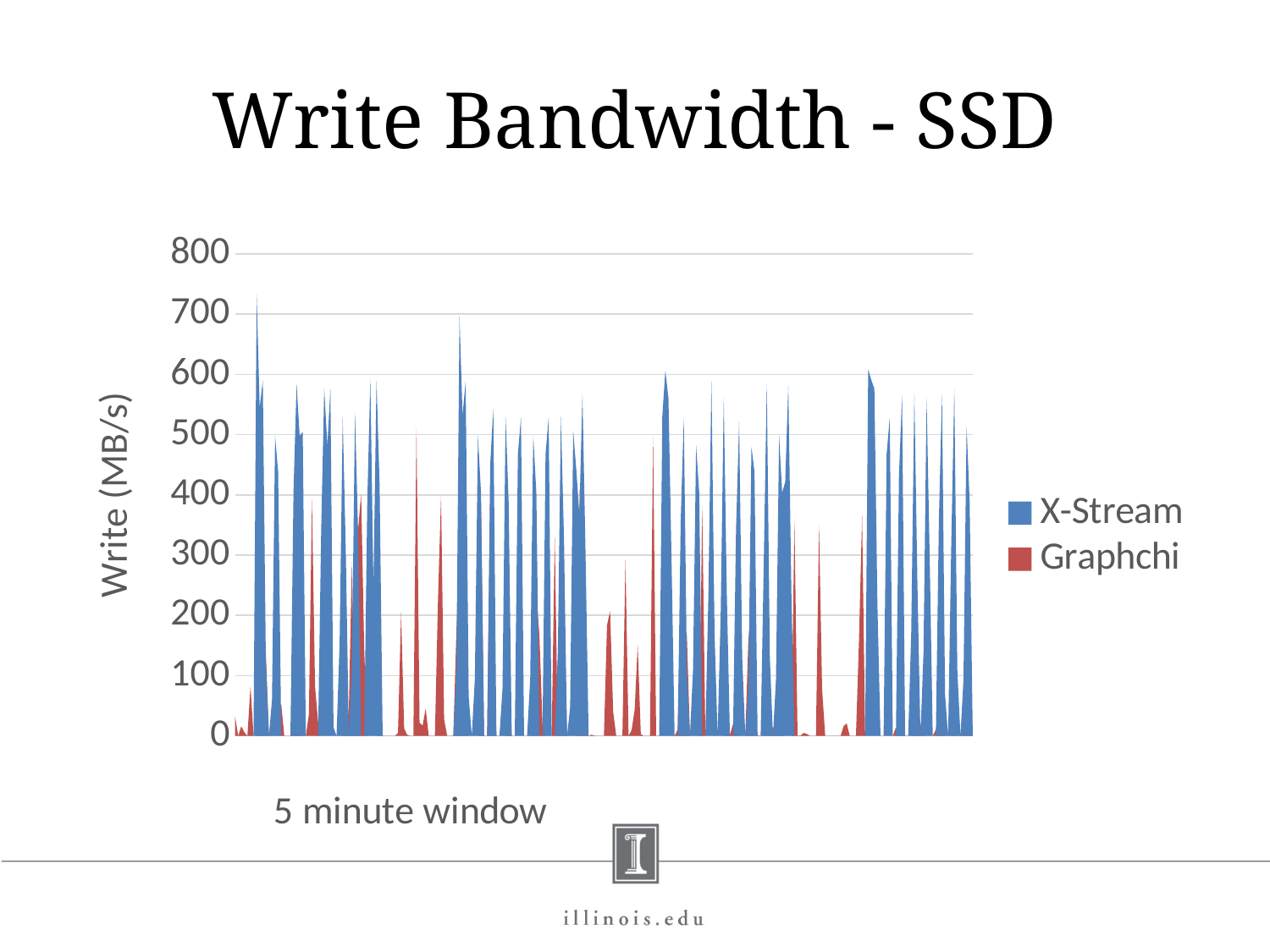
Which series reaches higher write bandwidth values, X-Stream or Graphchi? X-Stream What kind of chart is shown on the slide? area chart Which colour represents the Graphchi series? red What are the two series named in the legend? X-Stream and Graphchi Is the highest peak of the Graphchi series greater or less than 300 MB/s? greater Is the highest peak of the Graphchi series greater or less than 600 MB/s? less What is the title of the chart? Write Bandwidth - SSD What is the label shown below the horizontal axis? 5 minute window What is the highest value shown on the vertical axis? 800 What is the label on the vertical axis? Write (MB/s) How many series does the legend list? 2 Is the highest peak of the X-Stream series greater or less than 600 MB/s? greater